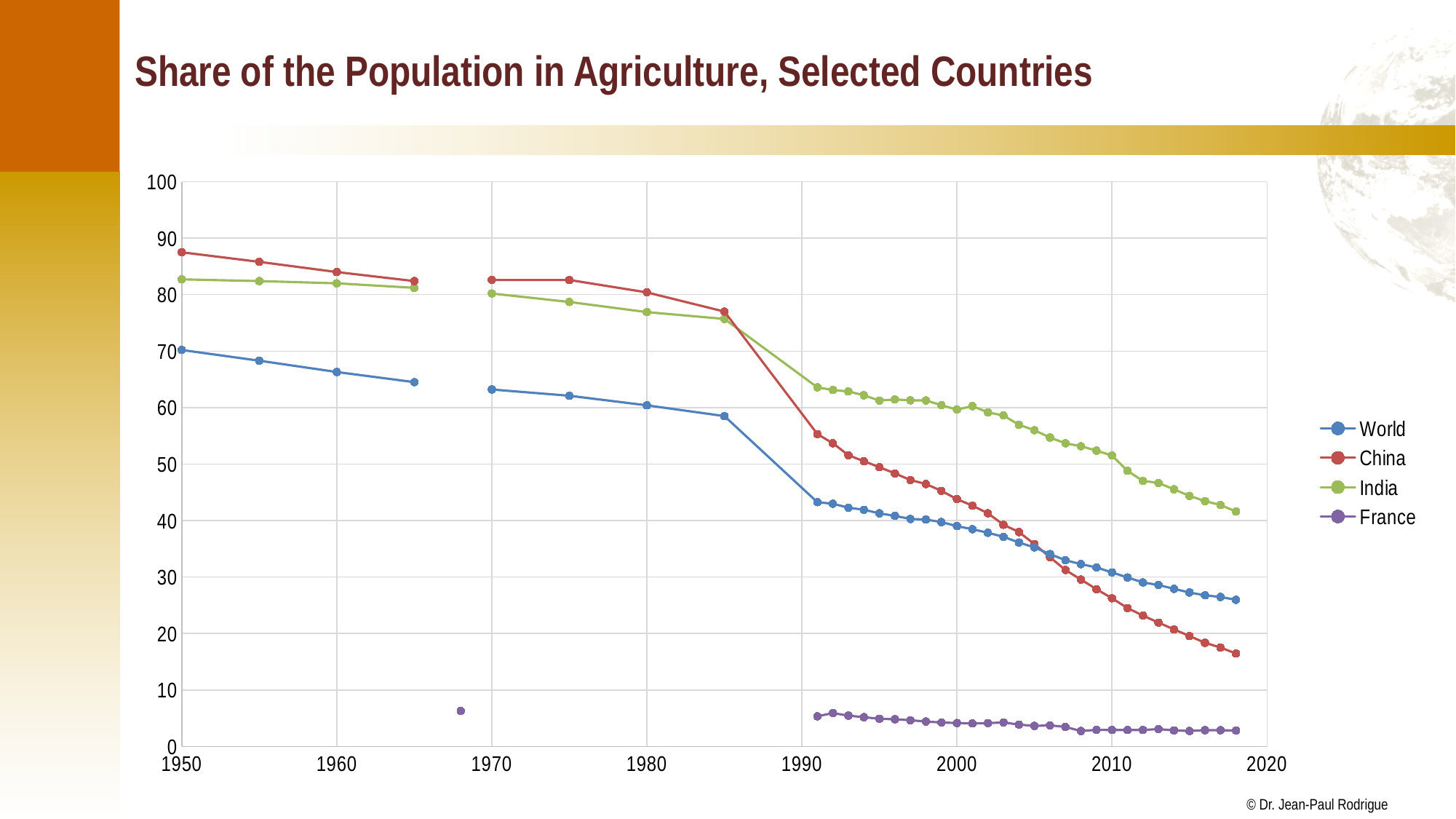
How many series does the legend list? 4 In 2018, which is larger, the value for World or the value for China? World Is the value for France in 2018 greater or less than 10? less What kind of chart is shown on the slide? line chart Which colour is used for the China series in the legend? red Which series has the highest value in 2018? India Which series has the highest value in 1950? China What is the title of the chart? Share of the Population in Agriculture, Selected Countries Is the value for China in 1950 greater or less than 80? greater Is the value for China in 2018 greater or less than 20? less Does the value for China rise or fall from 1950 to 2018? fall Which series has the lowest values across the whole chart? France